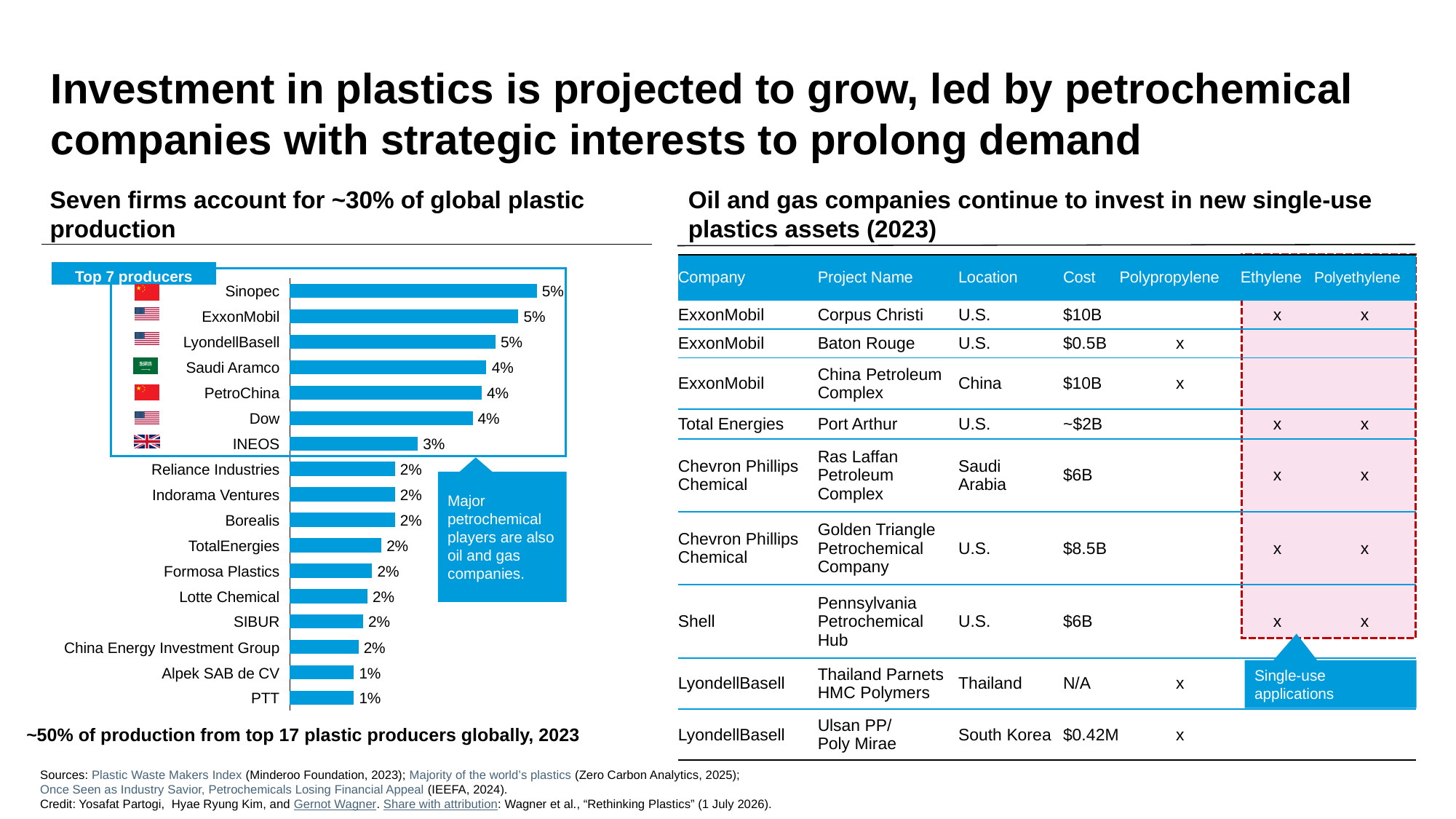
Which has a larger value in the bar chart, Dow or INEOS? Dow Which has a larger value in the bar chart, INEOS or Borealis? INEOS What is the difference between the values for Sinopec and INEOS in the bar chart? 2% What share of global plastic production does Sinopec account for in the bar chart? 5% What value is shown for Reliance Industries in the bar chart? 2% What kind of chart is used to show the plastic producers' shares? Bar chart What value is shown for PTT in the bar chart? 1% What value is shown for INEOS in the bar chart? 3% Do the values in the bar chart rise or fall going from the top producer to the bottom producer? Fall How many producers are enclosed in the 'Top 7 producers' box on the bar chart? 7 What value is shown for Saudi Aramco in the bar chart? 4% How many producers are listed in the bar chart? 17